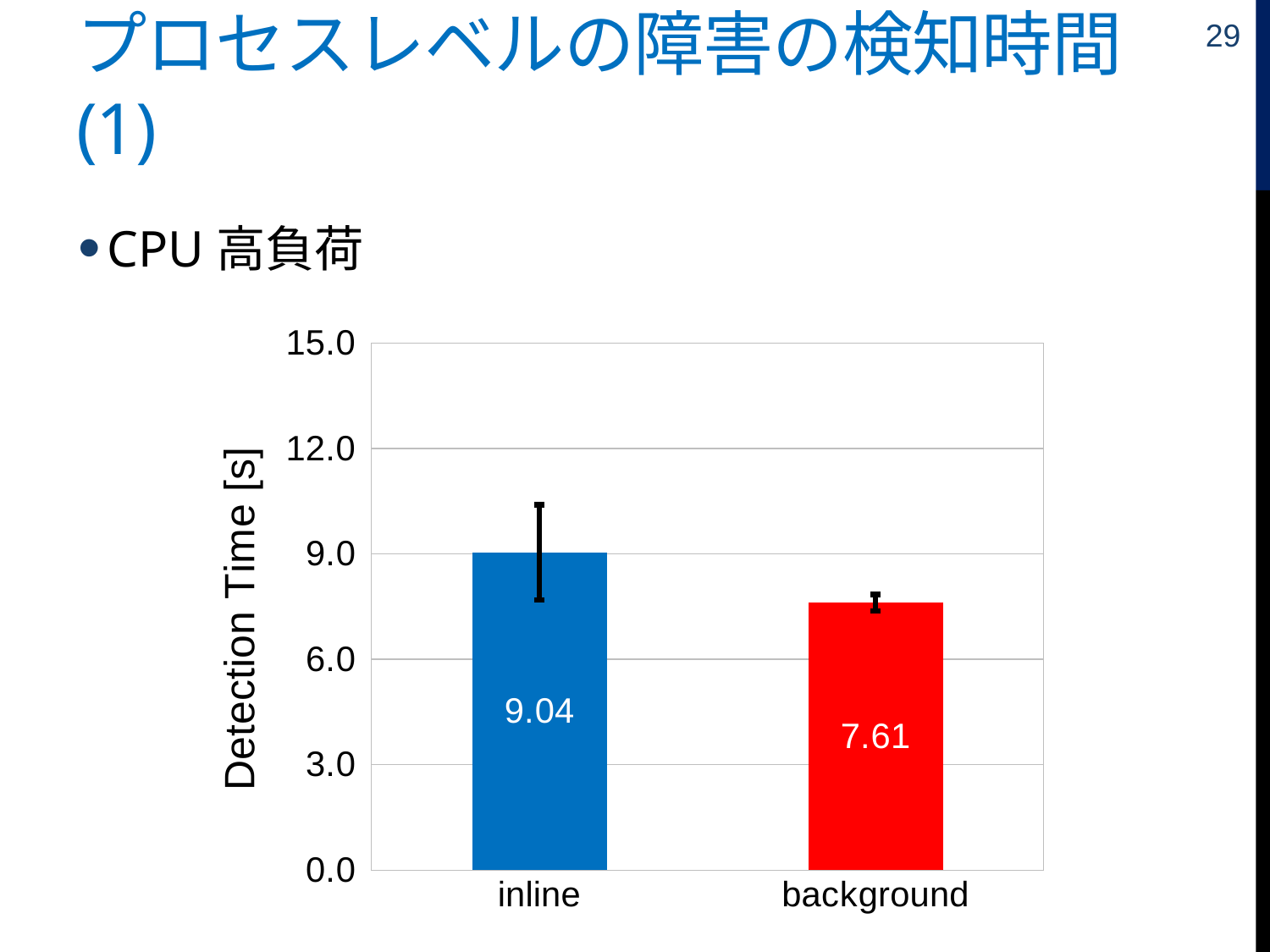
What colour is the bar for background? red Which has a larger detection time, inline or background? inline Is the value for inline greater or less than 6.0? greater What is the difference in detection time between inline and background? 1.43 What is the detection time for background? 7.61 What kind of chart is shown on the slide? bar chart Which category has the lowest detection time? background Which category has the highest detection time? inline Is the value for background greater or less than 9.0? less How many categories are shown on the x axis? 2 What is the detection time for inline? 9.04 What is the label of the y axis? Detection Time [s]